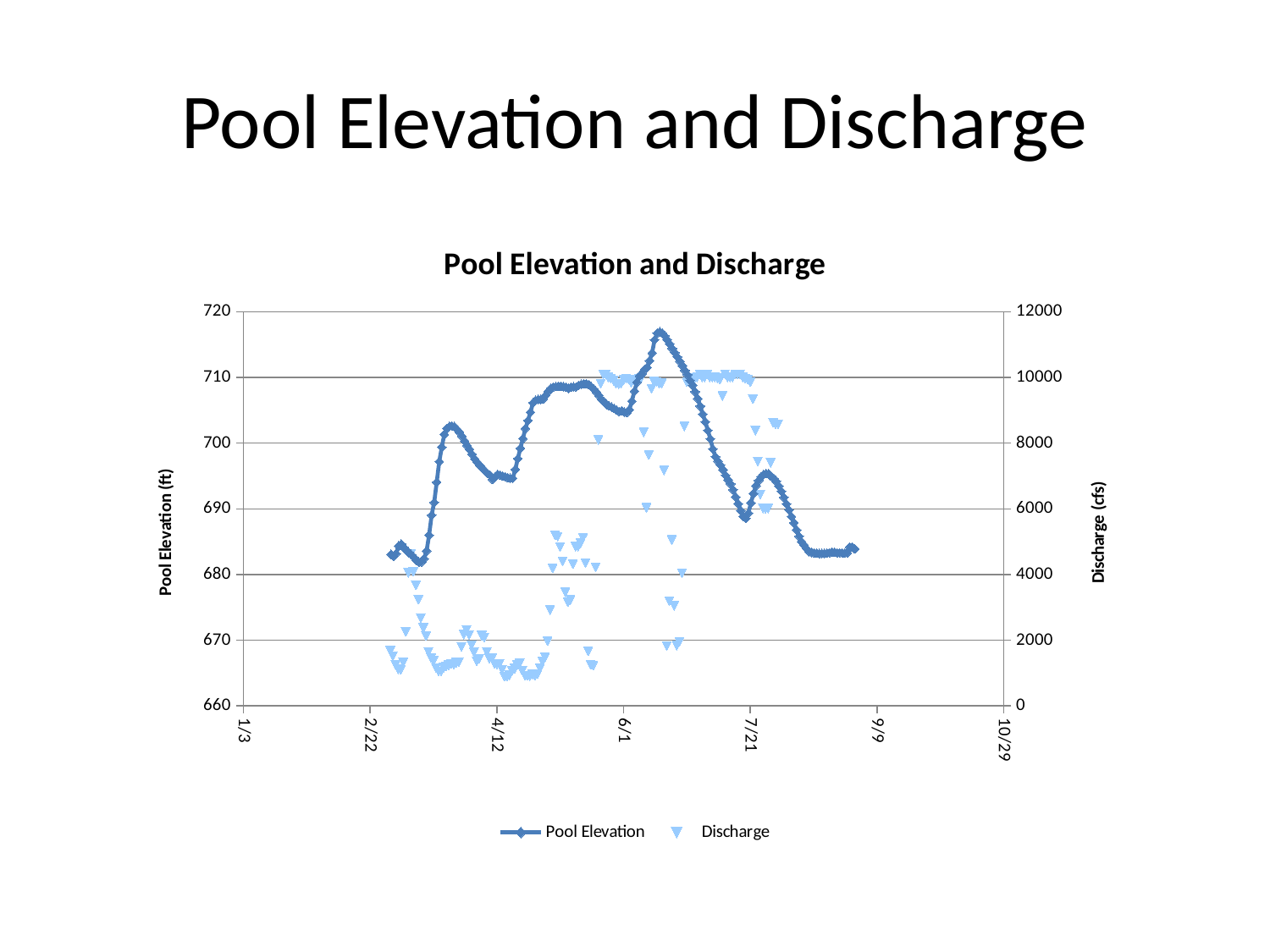
Is the Pool Elevation value at the start of the plotted data (early March) greater or less than 690? less Is the Pool Elevation value at the 4/12 tick greater or less than 690? greater What is the label of the left vertical axis? Pool Elevation (ft) Is the Discharge value at the 4/12 tick greater or less than 4000? less What is the label of the right vertical axis? Discharge (cfs) What kind of chart is shown on the slide? line chart How many series does the chart legend list? 2 Does Pool Elevation generally rise or fall from its mid-June peak to the 9/9 tick? fall Does Pool Elevation generally rise or fall between the 2/22 tick and its peak in mid-June? rise